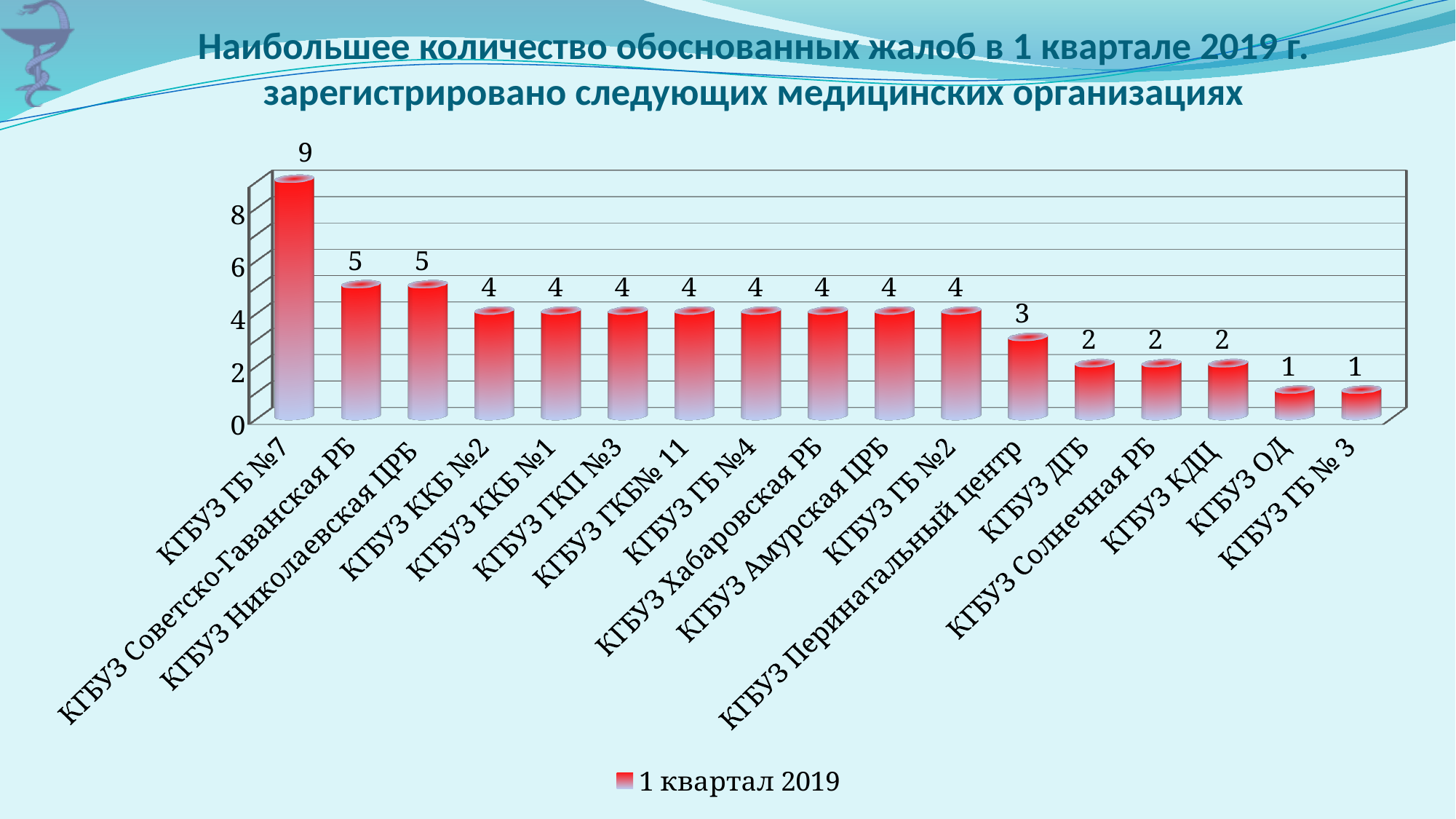
Which category has the highest value? КГБУЗ ГБ №7 What is the legend entry for the series? 1 квартал 2019 How many series does the legend list? 1 What kind of chart is shown on the slide? bar chart What is the value for КГБУЗ ГБ №7? 9 Which is larger, the value for КГБУЗ ДГБ or the value for КГБУЗ ГБ №4? КГБУЗ ГБ №4 What is the difference between the values for КГБУЗ ГБ №7 and КГБУЗ Советско-Гаванская РБ? 4 What is the value for КГБУЗ Солнечная РБ? 2 What is the value for КГБУЗ Перинатальный центр? 3 How many categories are shown on the chart? 17 What is the value for КГБУЗ Николаевская ЦРБ? 5 What is the lowest value shown on the chart? 1